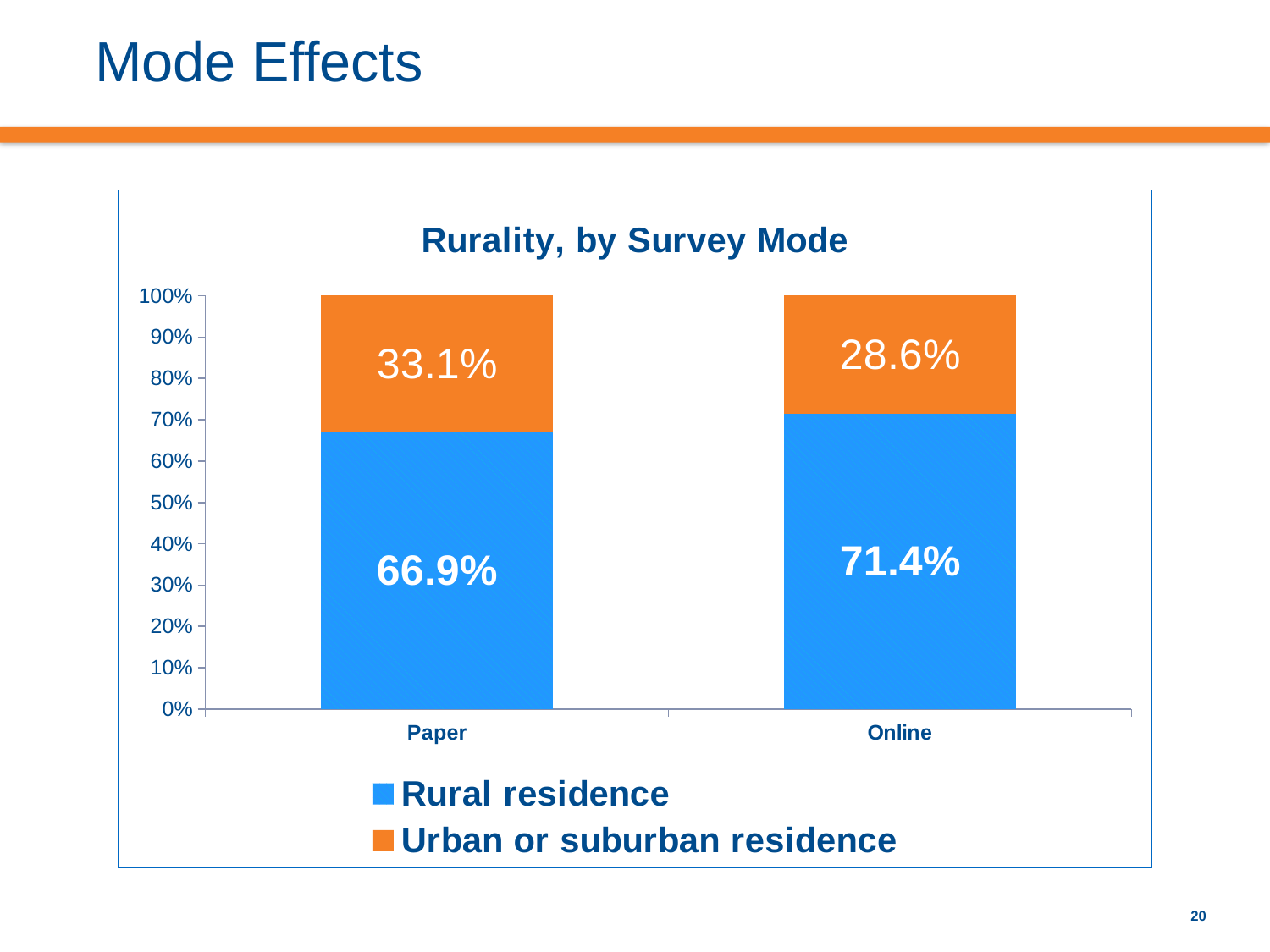
What is the Rural residence value for Paper? 66.9% Which survey mode has the higher Rural residence share? Online How many series does the legend list? 2 What is the difference between the Rural residence values for Online and Paper? 4.5% What is the Rural residence value for Online? 71.4% Is the Urban or suburban residence value for Paper larger or smaller than the Urban or suburban residence value for Online? larger Which survey mode has the lower Urban or suburban residence share? Online What is the title of the chart? Rurality, by Survey Mode What kind of chart is shown? stacked bar chart What is the Urban or suburban residence value for Paper? 33.1% What is the Urban or suburban residence value for Online? 28.6% How many survey modes are shown on the x axis? 2